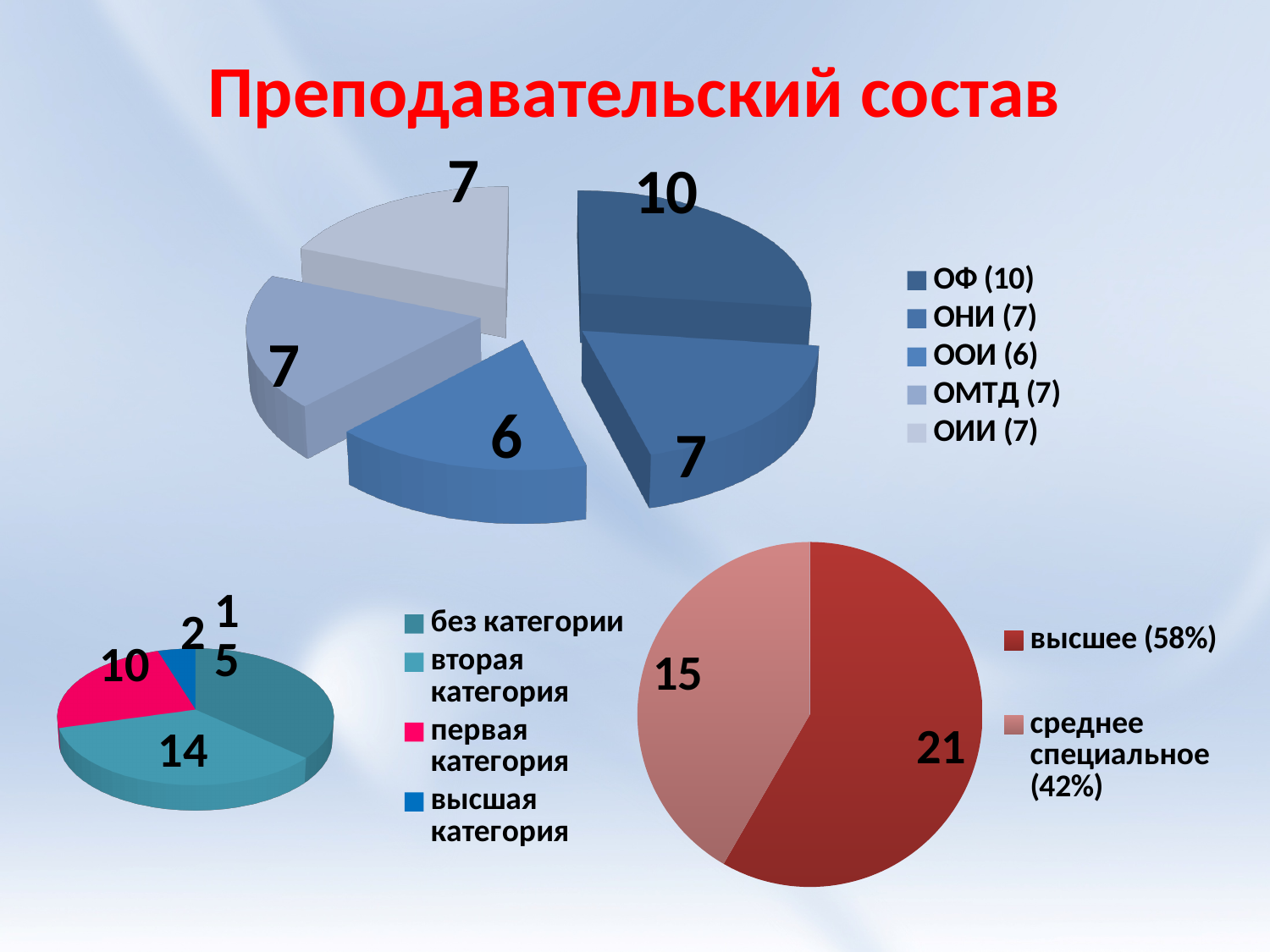
On the bottom-right pie chart, what is the value for высшее? 21 What type of chart is the bottom-right chart? pie chart On the top pie chart, which department has the largest slice? ОФ On the bottom-right pie chart, what share does среднее специальное have? 42% On the bottom-left pie chart, what is the value for высшая категория? 2 On the top pie chart, how many departments are shown in the legend? 5 On the top pie chart, what is the value for ООИ? 6 On the top pie chart, which department has the smallest slice? ООИ On the bottom-left pie chart, what is the value for первая категория? 10 On the top pie chart, what is the difference between the values for ОФ and ООИ? 4 On the top pie chart, what is the value for ОФ? 10 On the bottom-left pie chart, which is larger: первая категория or высшая категория? первая категория